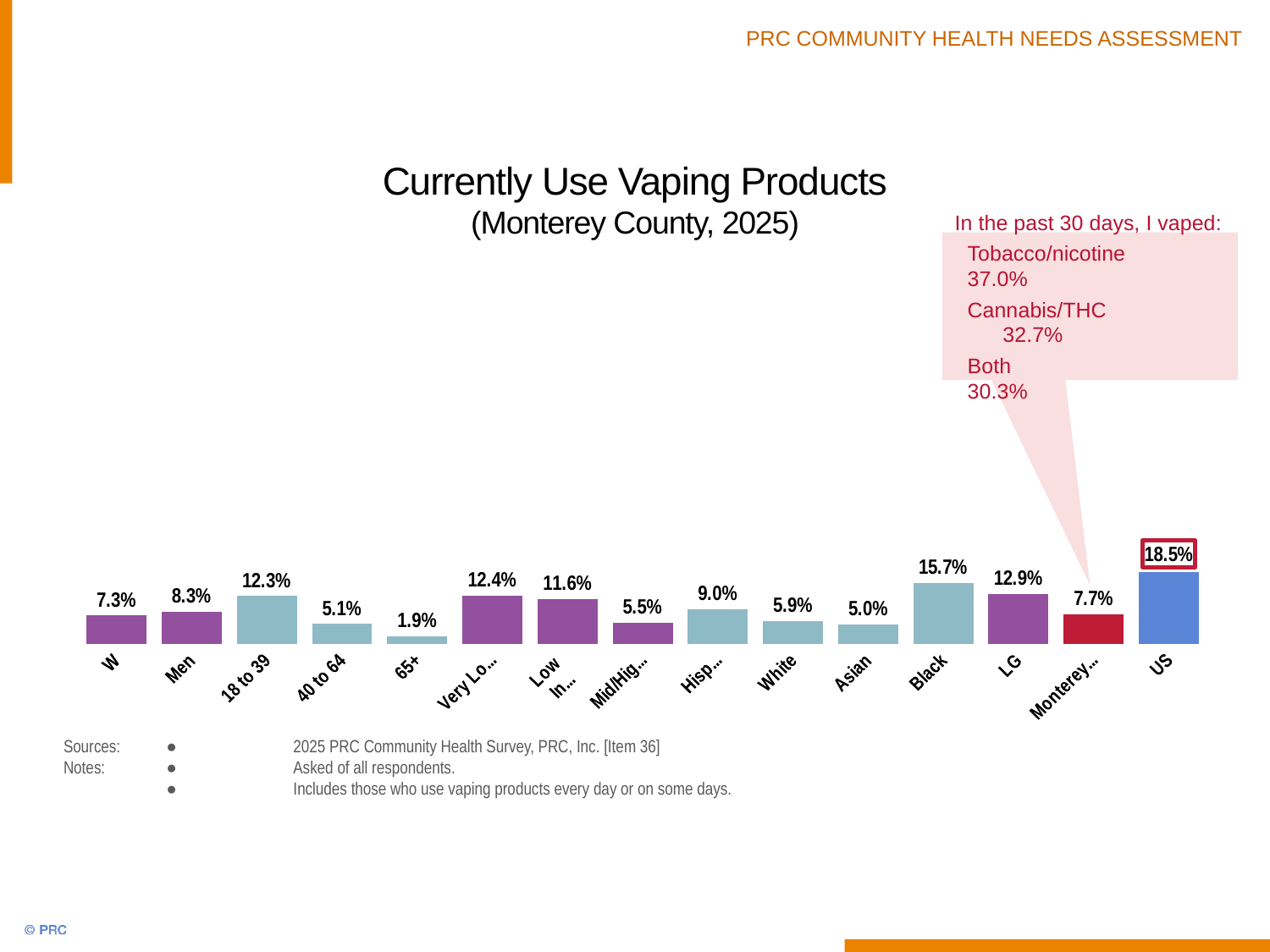
What kind of chart is shown on the slide? Bar chart How many bars are shown in the chart? 15 What is the value for US? 18.5% Which category has the lowest value? 65+ What is the value for Asian respondents? 5.0% Which is larger, the value for 18 to 39 or the value for 40 to 64? 18 to 39 What is the value for the 65+ age group? 1.9% What is the difference between the values for Black and White respondents? 9.8 percentage points What is the value for Black respondents? 15.7% What is the value for Men? 8.3% Which category has the highest value? US What is the title of the chart? Currently Use Vaping Products (Monterey County, 2025)